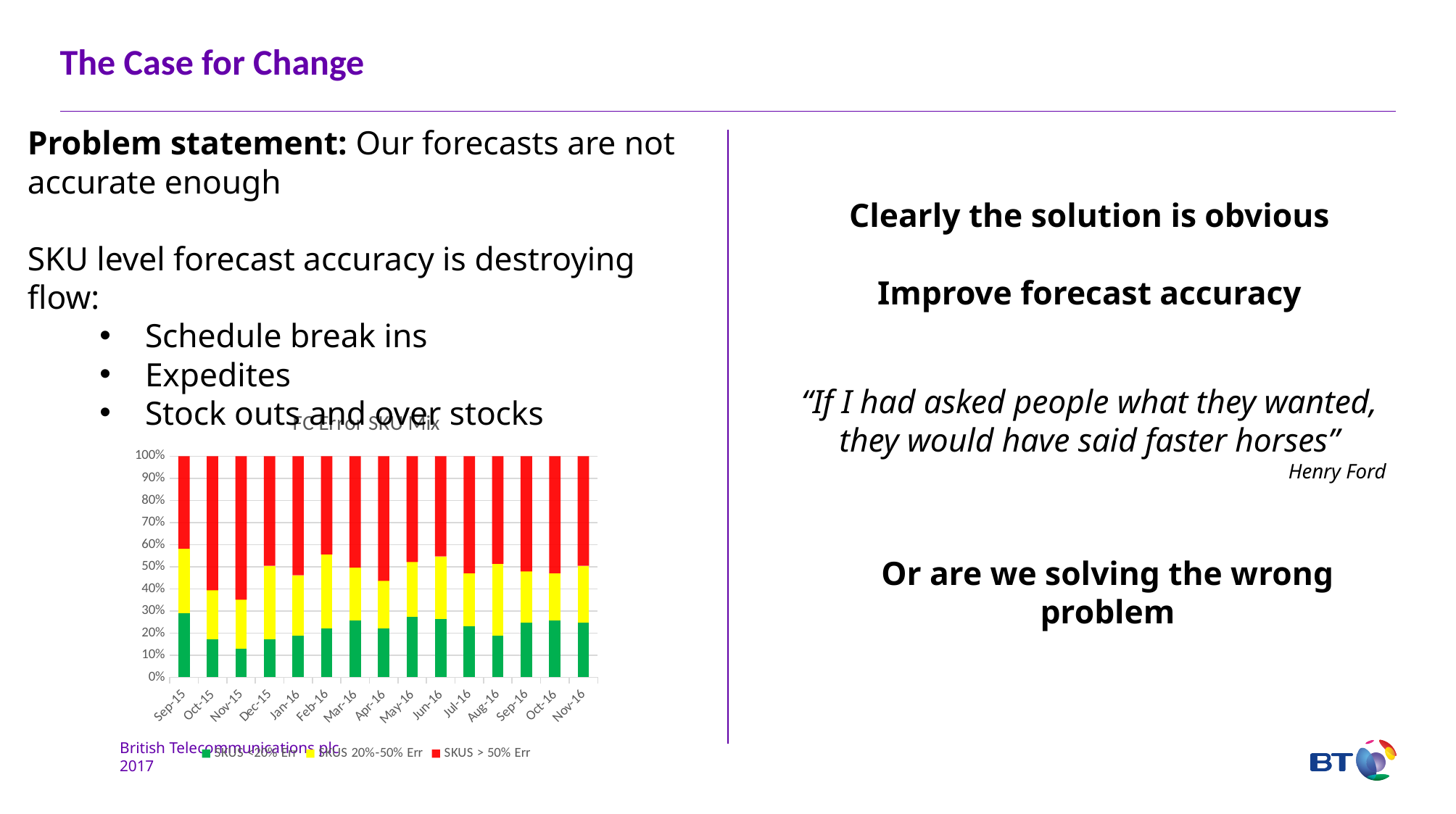
Is the value for the green series (SKUS <20% Err) in Sep-15 greater or less than 20%? greater What is the total height of each stacked bar in the chart? 100% What is the title of the chart on the slide? FC Error SKU Mix How many months are plotted along the x axis of the chart? 15 Which series is shown in red in the chart? SKUS > 50% Err How many series does the chart's legend list? 3 Which month has the largest red segment (SKUS > 50% Err)? Nov-15 Which month has the highest value for the green series (SKUS <20% Err)? Sep-15 Which month has the lowest value for the green series (SKUS <20% Err)? Nov-15 Is the value for the green series (SKUS <20% Err) in Nov-15 greater or less than 20%? less What kind of chart is shown on the slide? stacked bar chart